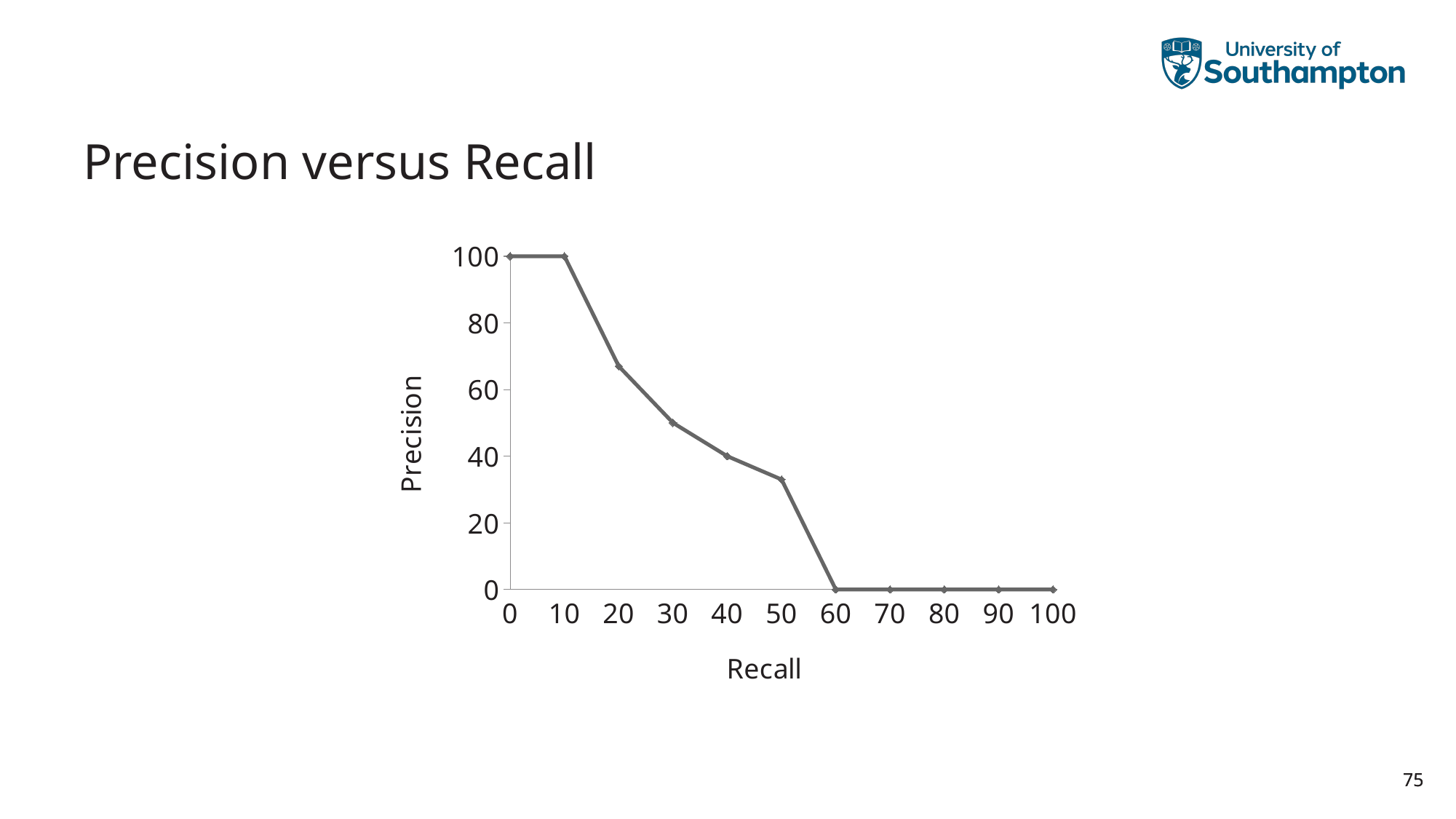
Is the precision at a recall of 20 greater or less than 60? greater What is the precision at a recall of 100? 0 What is the precision at a recall of 60? 0 What kind of chart is shown on the slide? line chart Does precision rise or fall as recall increases along the x axis? fall Is the precision at a recall of 50 greater or less than 40? less What is the precision at a recall of 0? 100 What is the difference in precision between a recall of 10 and a recall of 40? 60 Which has the higher precision: a recall of 20 or a recall of 50? recall of 20 What is the precision at a recall of 10? 100 Is the precision at a recall of 30 greater or less than 60? less What is the precision at a recall of 40? 40